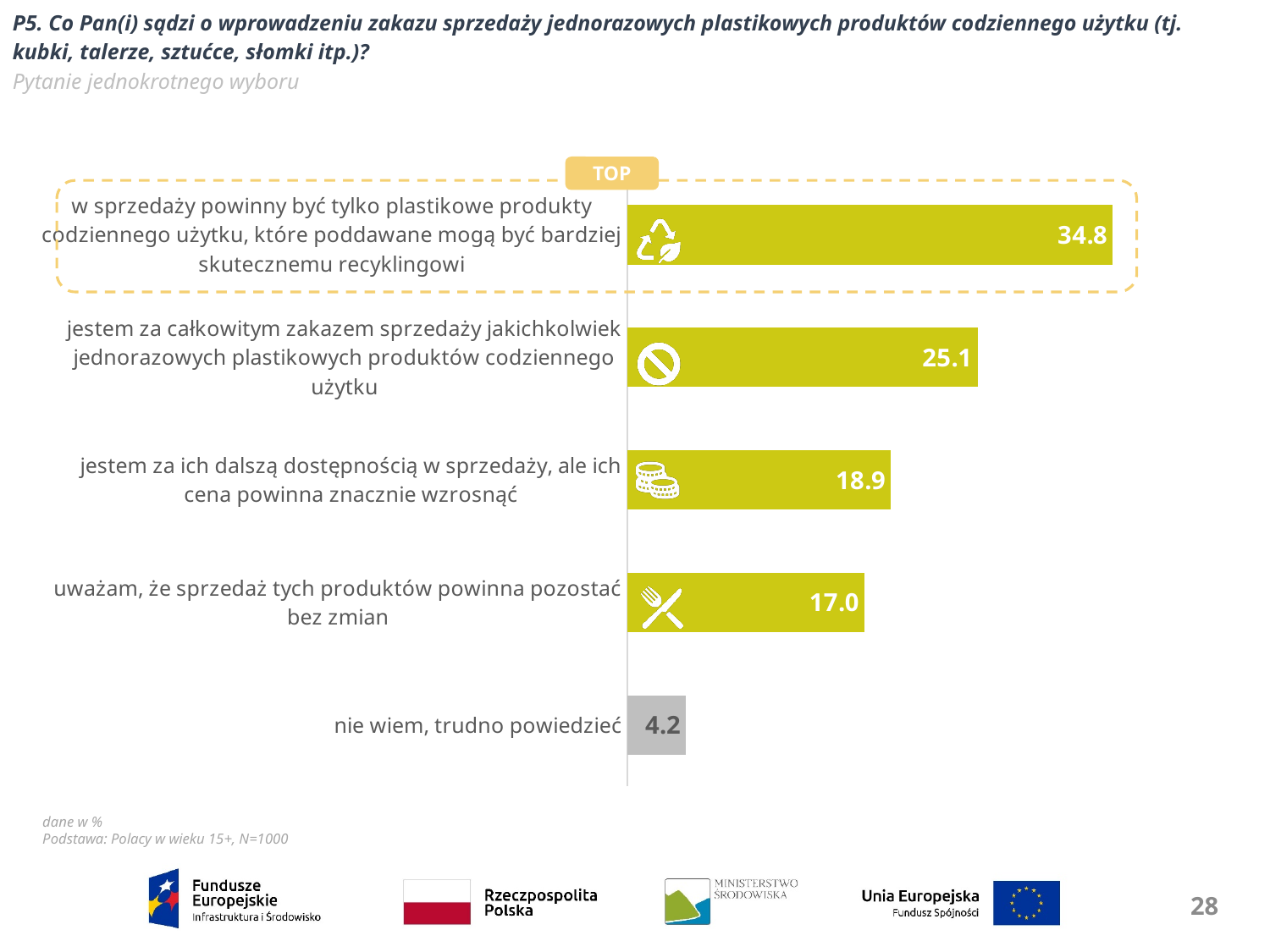
What is the value for "nie wiem, trudno powiedzieć"? 4.2 What is the value for "jestem za całkowitym zakazem sprzedaży jakichkolwiek jednorazowych plastikowych produktów codziennego użytku"? 25.1 What is the difference between the values for "jestem za ich dalszą dostępnością w sprzedaży, ale ich cena powinna znacznie wzrosnąć" and "uważam, że sprzedaż tych produktów powinna pozostać bez zmian"? 1.9 Which category has the lowest value? nie wiem, trudno powiedzieć What kind of chart is shown on the slide? bar chart What is the difference between the highest value (34.8) and the value for "jestem za całkowitym zakazem" (25.1)? 9.7 Which is larger: the value for "jestem za całkowitym zakazem" or the value for "uważam, że sprzedaż tych produktów powinna pozostać bez zmian"? jestem za całkowitym zakazem What is the value for "jestem za ich dalszą dostępnością w sprzedaży, ale ich cena powinna znacznie wzrosnąć"? 18.9 Which category has the highest value? w sprzedaży powinny być tylko plastikowe produkty codziennego użytku, które poddawane mogą być bardziej skutecznemu recyklingowi How many categories are shown in the chart? 5 What is the value for "uważam, że sprzedaż tych produktów powinna pozostać bez zmian"? 17.0 Which category is marked with the "TOP" label? w sprzedaży powinny być tylko plastikowe produkty codziennego użytku, które poddawane mogą być bardziej skutecznemu recyklingowi